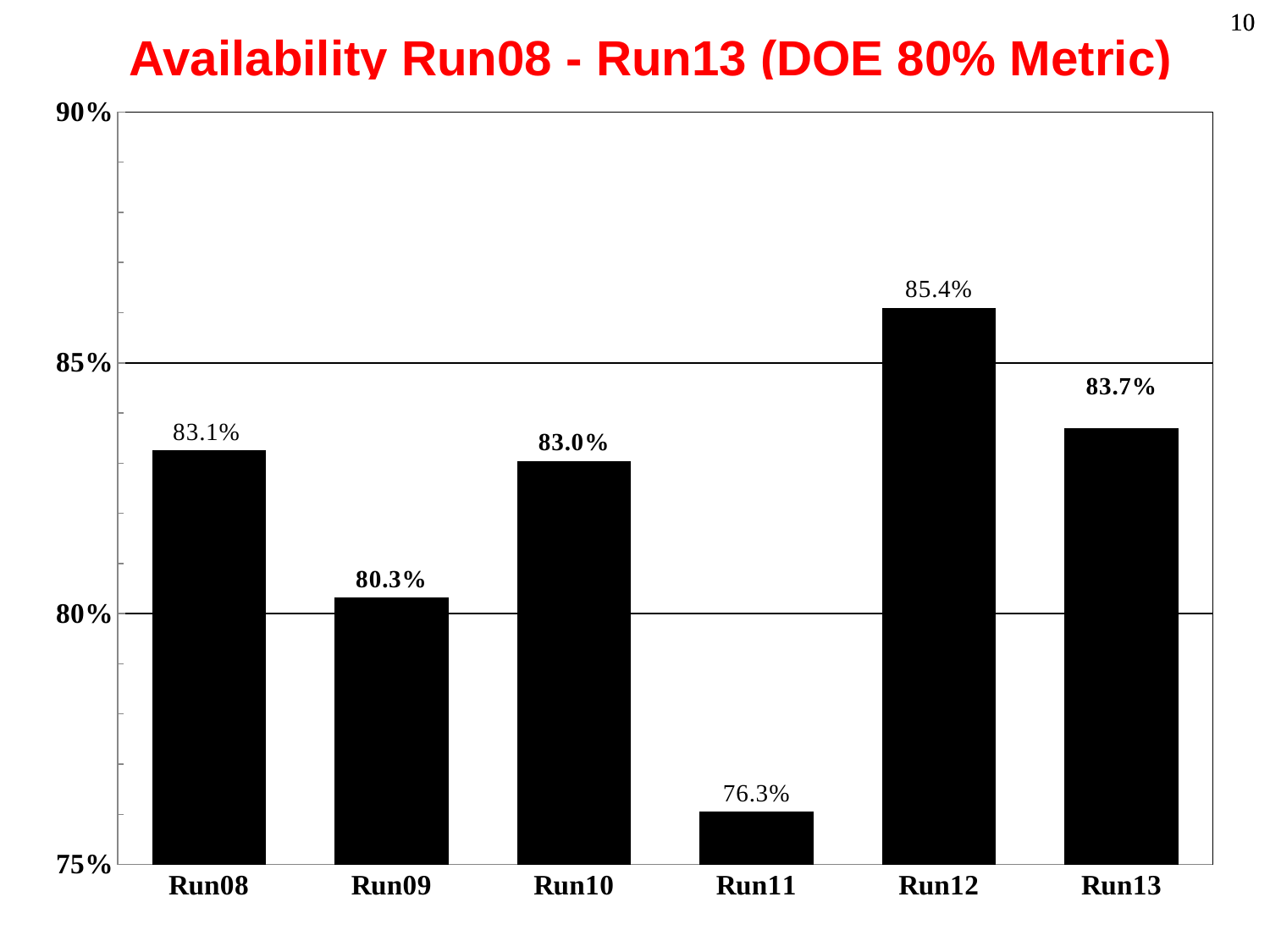
What is the difference between the availability for Run13 and Run08? 0.6% Which run has the highest availability? Run12 Is the value for Run11 greater or less than 80%? less What is the availability value for Run12? 85.4% What is the title of the chart? Availability Run08 - Run13 (DOE 80% Metric) What is the difference between the availability for Run12 and Run11? 9.1% Which run has the lowest availability? Run11 Which has a higher availability, Run13 or Run10? Run13 What is the availability value for Run09? 80.3% What is the availability value for Run11? 76.3% How many runs are shown on the chart? 6 What kind of chart is shown on the slide? bar chart